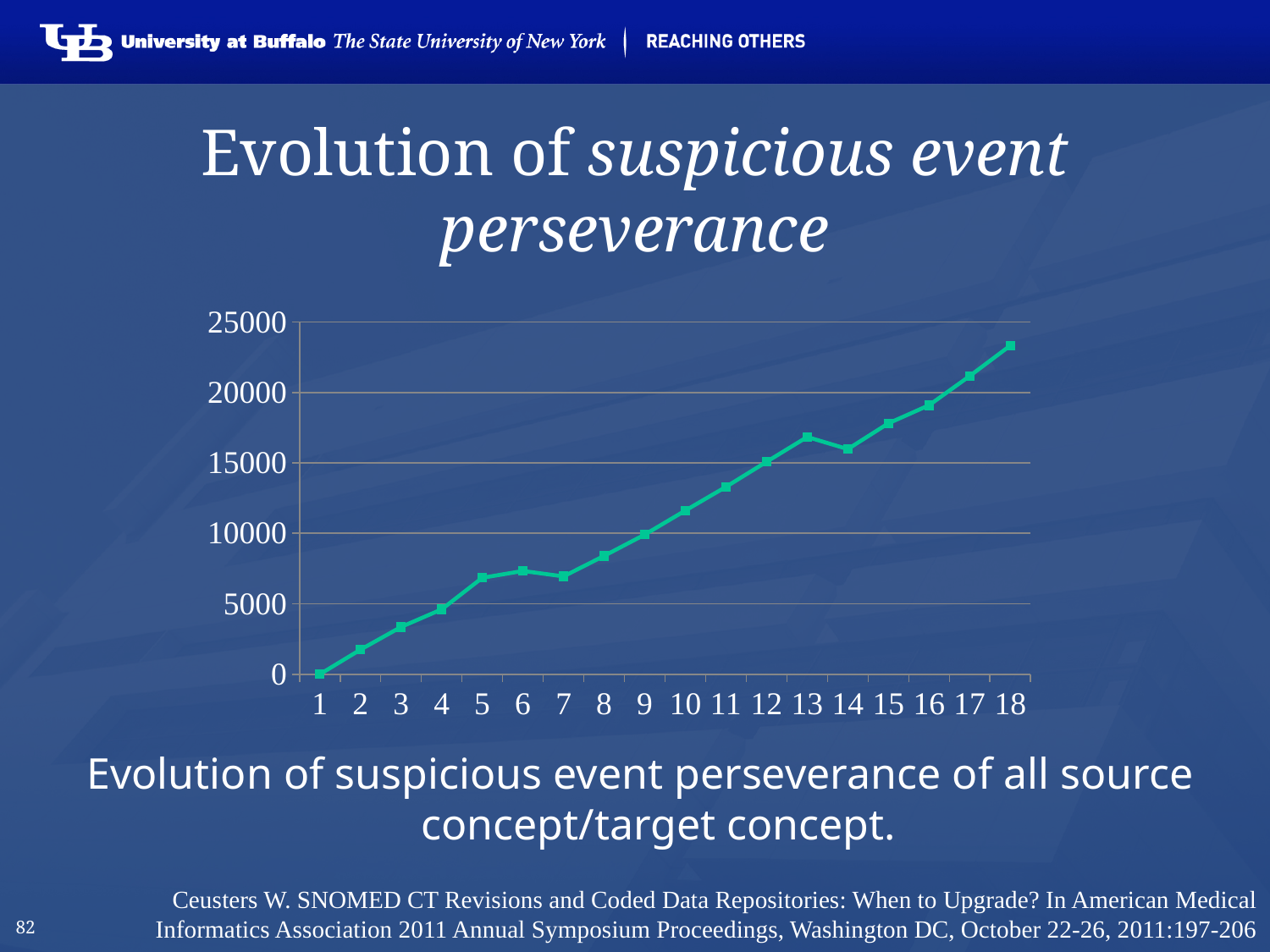
Is the value at point 11 greater or less than 10000? greater What kind of chart is shown on the slide? line chart Do the values in the chart generally rise or fall from point 1 to point 18? rise What is the title of the slide containing the chart? Evolution of suspicious event perseverance Which has the larger value, point 10 or point 14? 14 How many points are plotted along the x axis of the chart? 18 What colour is the line plotted in the chart? green Is the value at point 15 greater or less than 20000? less Is the value at point 18 greater or less than 20000? greater Which x-axis point has the lowest value in the chart? 1 Which x-axis point has the highest value in the chart? 18